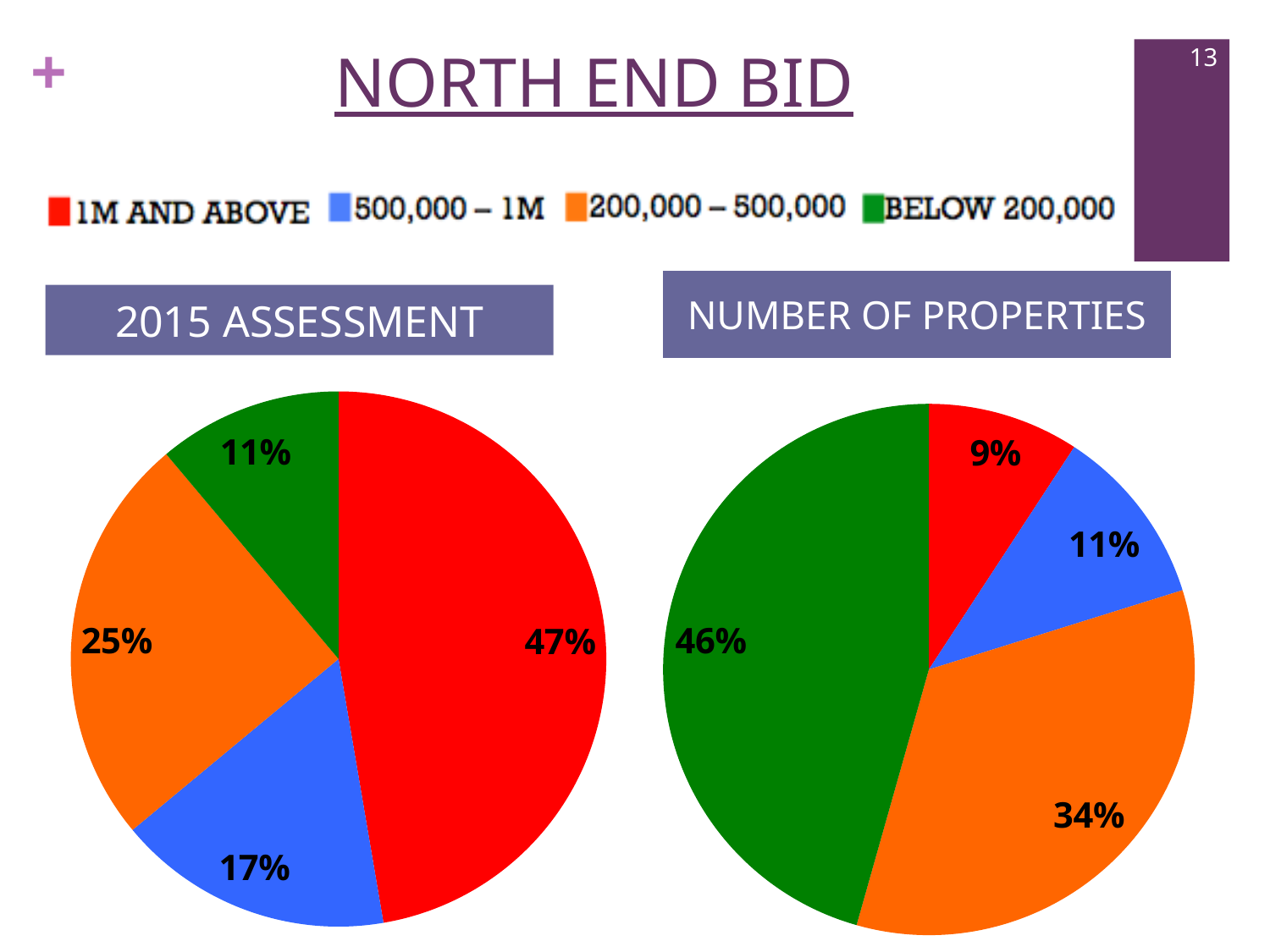
In the 2015 ASSESSMENT pie chart, what is the value for 500,000 – 1M? 17% In the 2015 ASSESSMENT pie chart, which category has the largest slice? 1M AND ABOVE In the 2015 ASSESSMENT pie chart, which is larger: the 200,000 – 500,000 slice or the 500,000 – 1M slice? 200,000 – 500,000 In the NUMBER OF PROPERTIES pie chart, what share does the BELOW 200,000 slice have? 46% In the NUMBER OF PROPERTIES pie chart, which category has the smallest slice? 1M AND ABOVE In the NUMBER OF PROPERTIES pie chart, what is the value for 200,000 – 500,000? 34% How many categories does the legend list? 4 What kind of chart is used for 2015 ASSESSMENT? Pie chart In the 2015 ASSESSMENT pie chart, which category has the smallest slice? BELOW 200,000 Which colour represents BELOW 200,000 in the legend? Green In the 2015 ASSESSMENT pie chart, what share does the 1M AND ABOVE slice have? 47% In the NUMBER OF PROPERTIES pie chart, what is the difference between the BELOW 200,000 slice and the 200,000 – 500,000 slice? 12%